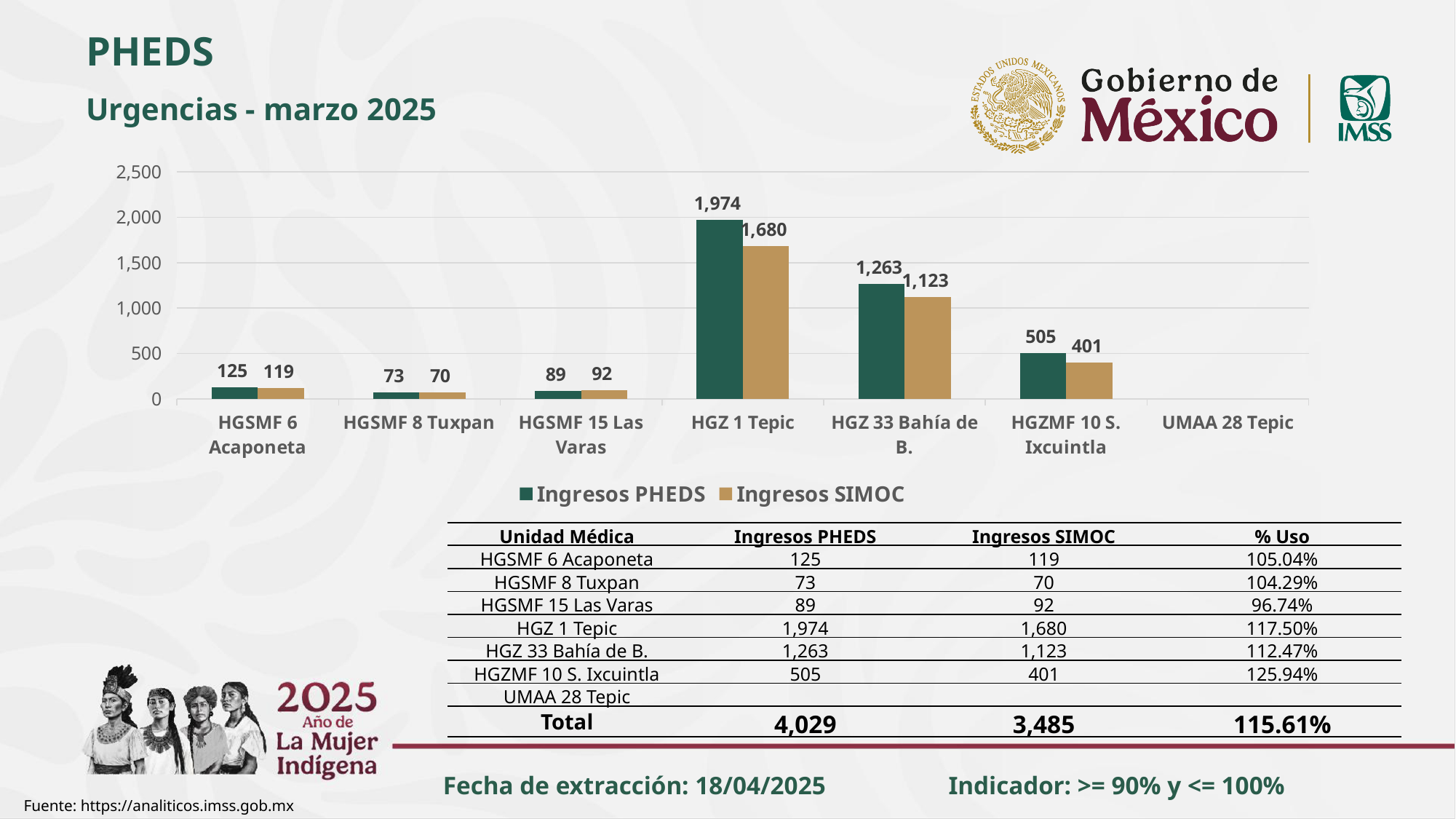
What is the Ingresos PHEDS value for HGZ 1 Tepic? 1,974 What kind of chart is shown on the slide? bar chart How many categories are shown on the x axis? 7 Which is larger for HGSMF 15 Las Varas, Ingresos PHEDS or Ingresos SIMOC? Ingresos SIMOC Which category with a plotted bar has the lowest Ingresos SIMOC value? HGSMF 8 Tuxpan How many series does the legend list? 2 What is the difference between Ingresos PHEDS and Ingresos SIMOC for HGZ 33 Bahía de B.? 140 What colour are the Ingresos PHEDS bars? dark green Which category has the highest Ingresos PHEDS value? HGZ 1 Tepic What is the Ingresos SIMOC value for HGSMF 15 Las Varas? 92 Is the Ingresos SIMOC value for HGZ 1 Tepic greater or less than 1,500? greater What is the Ingresos SIMOC value for HGZMF 10 S. Ixcuintla? 401